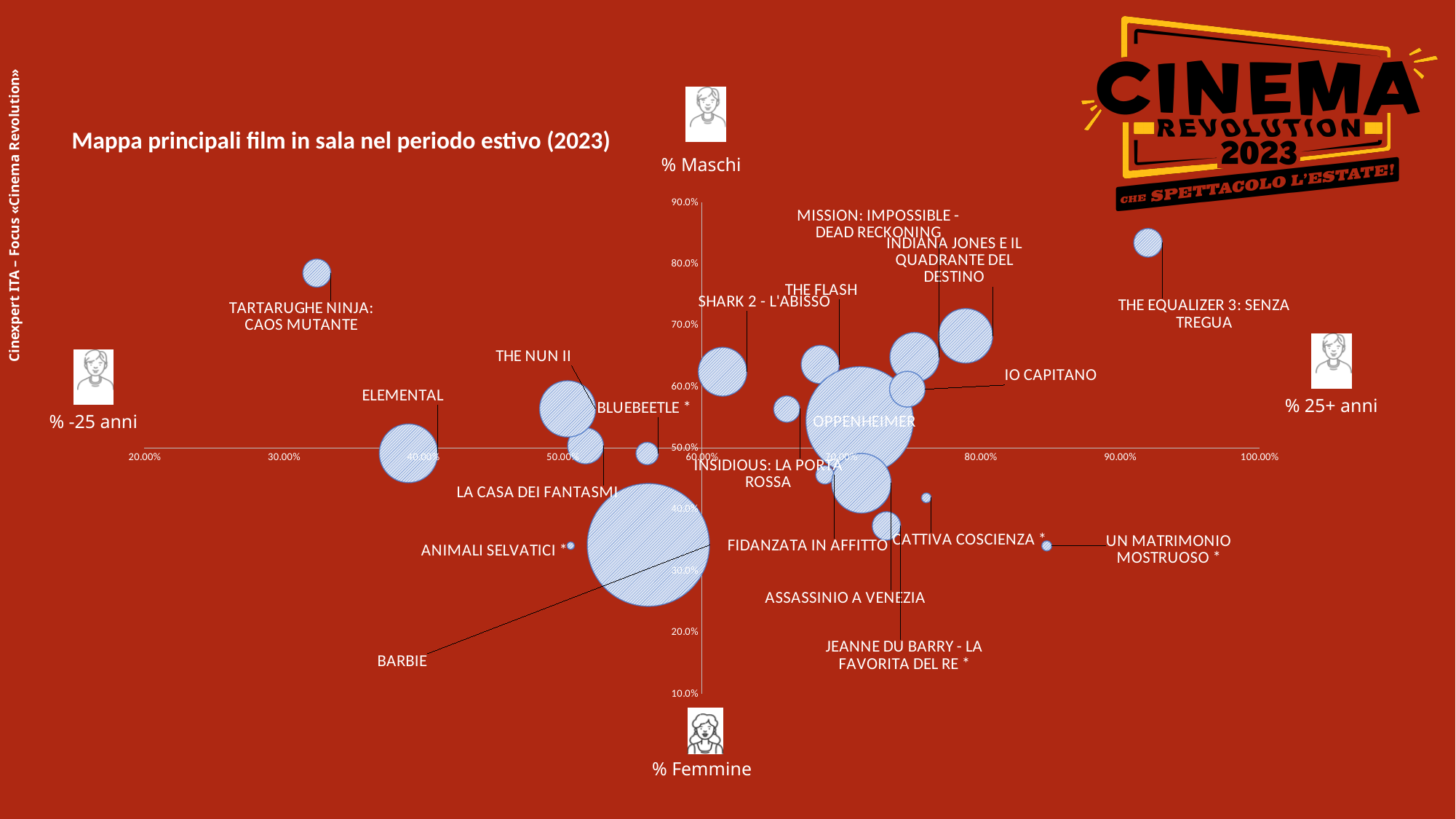
What label is shown at the top of the vertical axis? % Maschi Is the vertical (% Maschi) value for BARBIE greater or less than 40.0%? less Is the horizontal value for THE EQUALIZER 3: SENZA TREGUA greater or less than 90.00%? greater What is the title of the chart? Mappa principali film in sala nel periodo estivo (2023) Is the horizontal value for ELEMENTAL greater or less than 50.00%? less Which film is plotted furthest to the right (highest % 25+ anni)? THE EQUALIZER 3: SENZA TREGUA Which film is plotted further to the right, INDIANA JONES E IL QUADRANTE DEL DESTINO or ELEMENTAL? INDIANA JONES E IL QUADRANTE DEL DESTINO Which film has the largest bubble on the chart? BARBIE Which film has a higher % Maschi value, TARTARUGHE NINJA: CAOS MUTANTE or BARBIE? TARTARUGHE NINJA: CAOS MUTANTE Which film is plotted furthest to the left (highest % -25 anni)? TARTARUGHE NINJA: CAOS MUTANTE What kind of chart is shown on the slide? Bubble chart